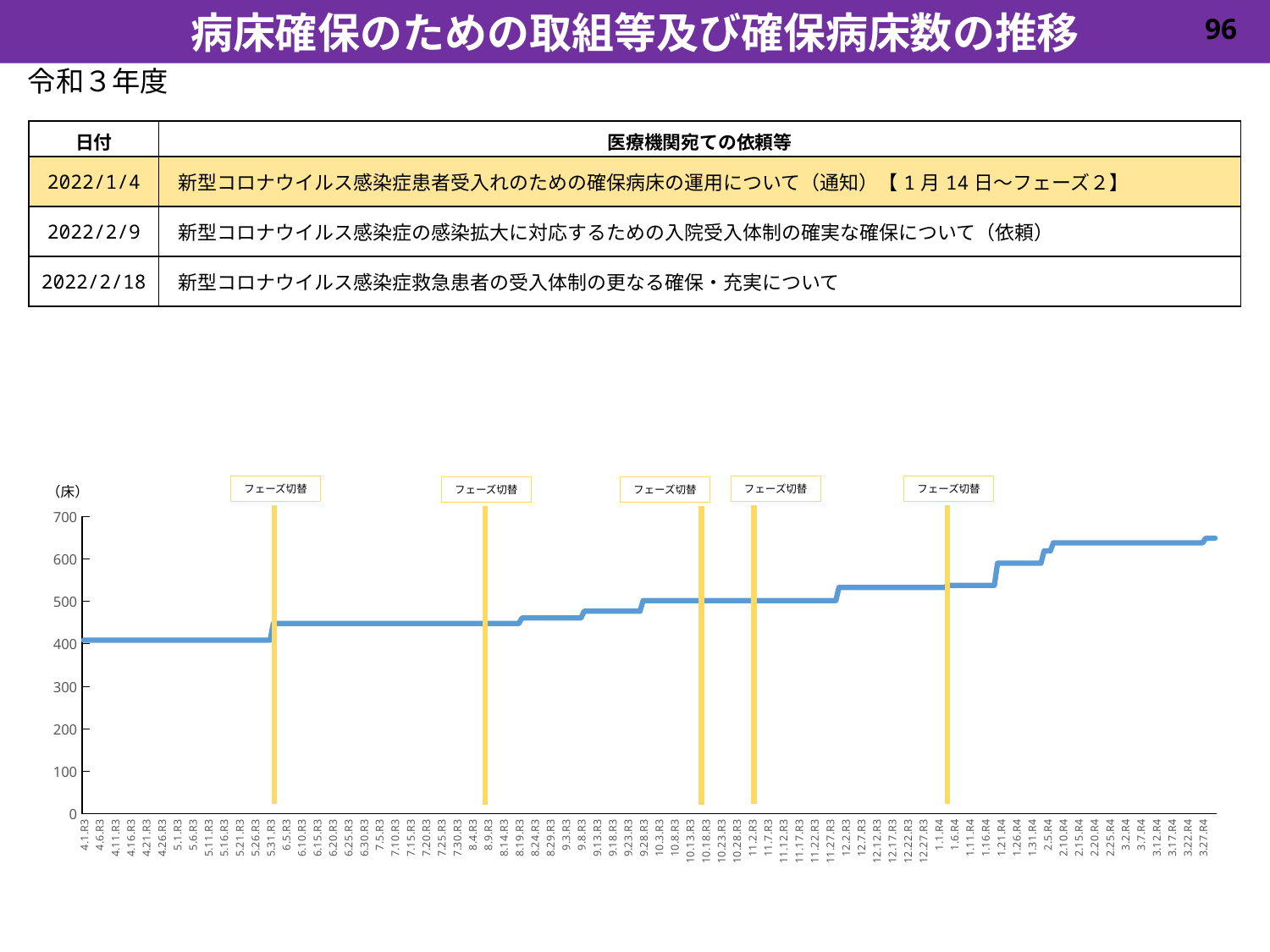
What unit label is shown at the top of the y axis of the line chart? (床) Is the value for 8.4.R3 in the line chart greater or less than 500? less Is the value for 8.4.R3 in the line chart greater or less than 400? greater Is the value for 3.27.R4 in the line chart greater or less than 600? greater Do the values in the line chart generally rise or fall from left to right along the x axis? rise What kind of chart is shown on the slide? line chart Which is larger in the line chart, the value for 4.1.R3 or the value for 3.27.R4? 3.27.R4 How many data series (lines) are plotted in the line chart? 1 What is the highest tick value shown on the y axis of the line chart? 700 How many vertical 'フェーズ切替' marker lines are drawn on the line chart? 5